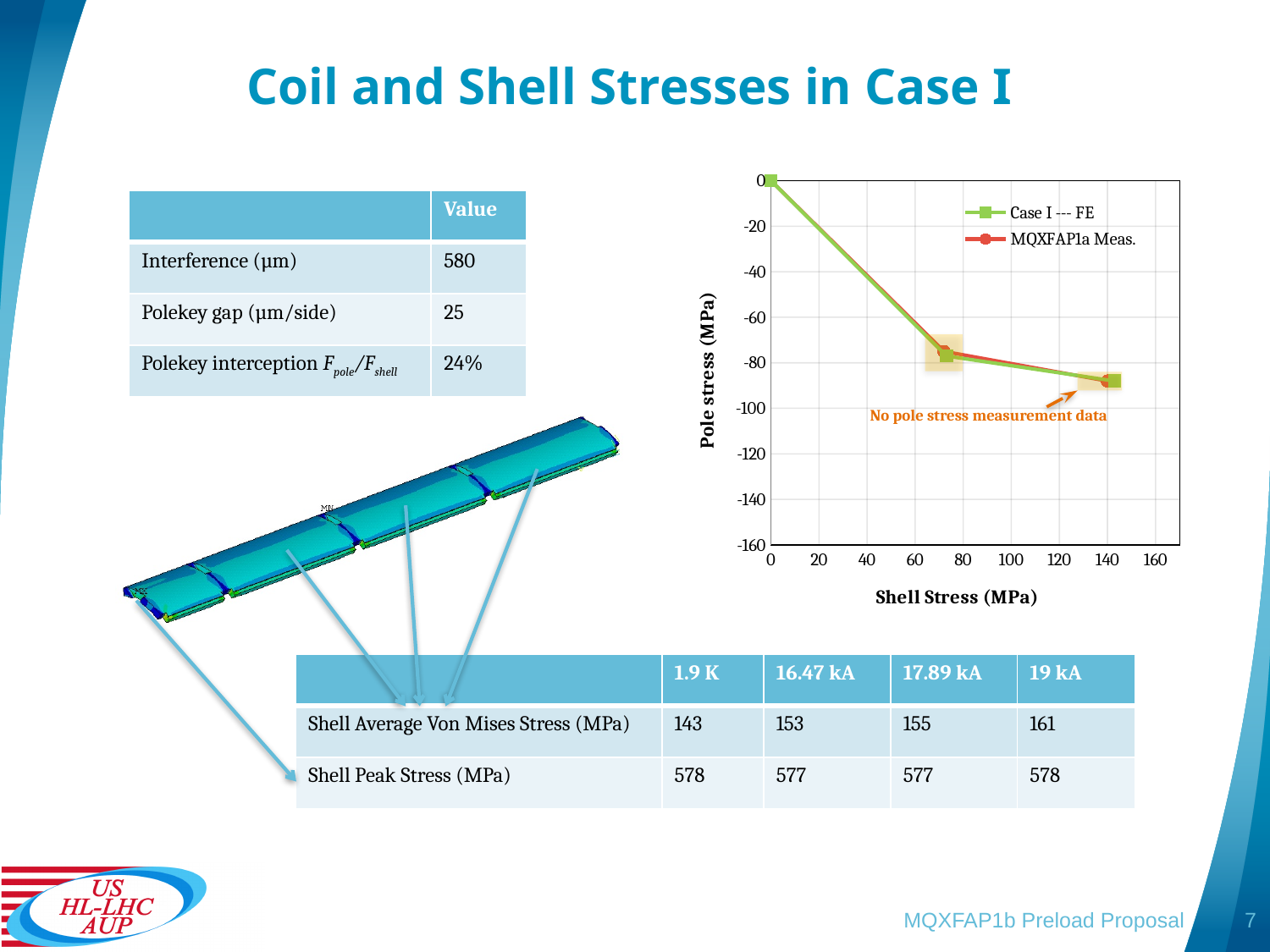
What is the lowest value shown on the chart's y axis? -160 What kind of chart is shown on the slide? line chart What are the two series named in the chart legend? Case I --- FE and MQXFAP1a Meas. Does the pole stress rise or fall as shell stress increases along the x axis? fall What is the label of the chart's x axis? Shell Stress (MPa) How many series does the chart legend list? 2 Is the pole stress at the right-most Case I --- FE point greater or less than -60? less How many data points are plotted for the Case I --- FE series? 3 Is the pole stress at the right-most MQXFAP1a Meas. point greater or less than -120? greater Is the pole stress at the middle Case I --- FE point (around 70 MPa shell stress) greater or less than -40? less